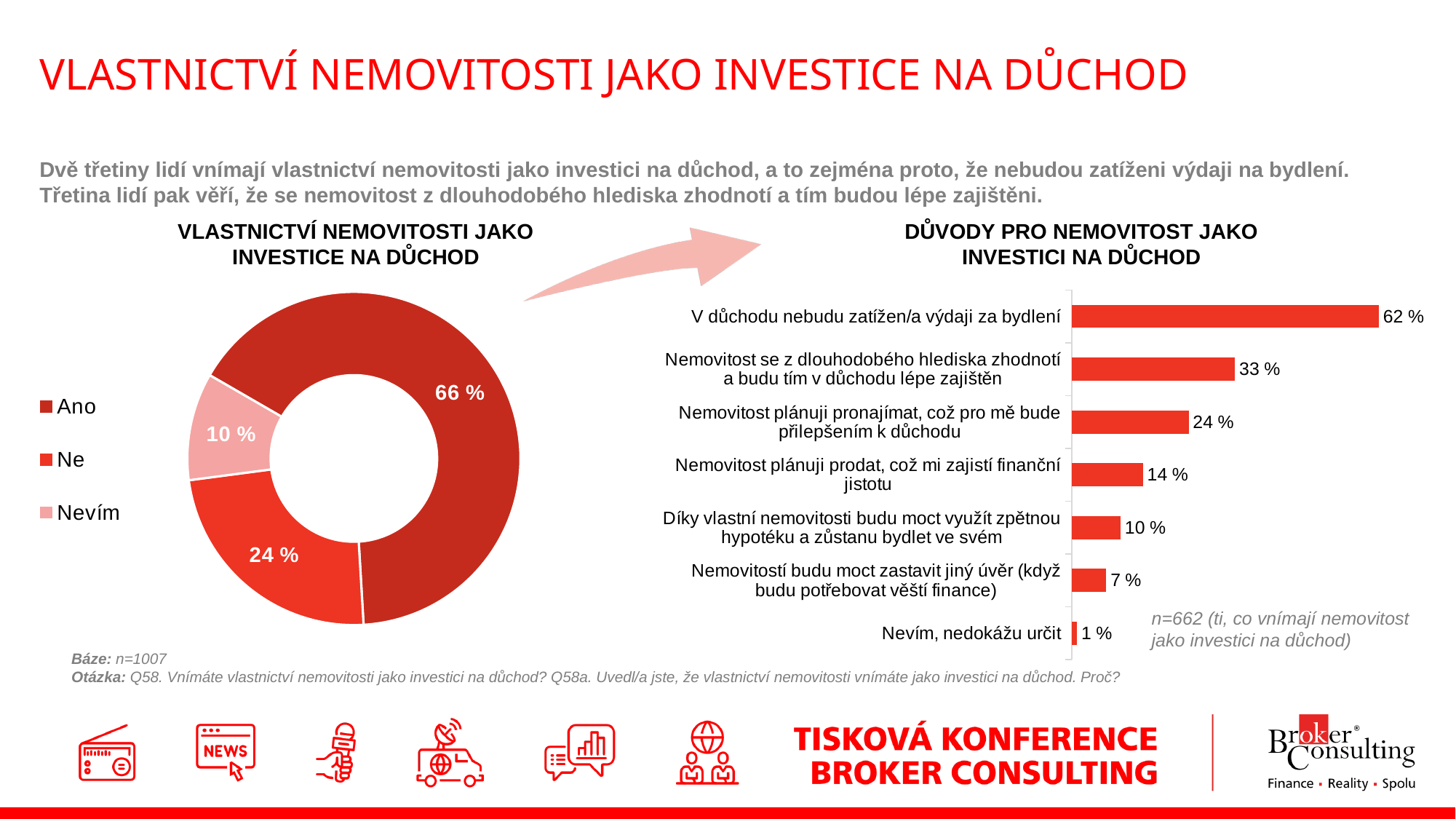
In the chart titled 'VLASTNICTVÍ NEMOVITOSTI JAKO INVESTICE NA DŮCHOD', what kind of chart is shown? Doughnut (pie) chart In the chart titled 'VLASTNICTVÍ NEMOVITOSTI JAKO INVESTICE NA DŮCHOD', what is the difference in percentage points between 'Ano' and 'Ne'? 42 percentage points In the chart titled 'DŮVODY PRO NEMOVITOST JAKO INVESTICI NA DŮCHOD', what is the value for 'V důchodu nebudu zatížen/a výdaji za bydlení'? 62 % In the chart titled 'VLASTNICTVÍ NEMOVITOSTI JAKO INVESTICE NA DŮCHOD', what share of respondents answered 'Nevím'? 10 % In the chart titled 'VLASTNICTVÍ NEMOVITOSTI JAKO INVESTICE NA DŮCHOD', what share of respondents answered 'Ano'? 66 % In the chart titled 'VLASTNICTVÍ NEMOVITOSTI JAKO INVESTICE NA DŮCHOD', how many categories does the legend list? 3 In the chart titled 'DŮVODY PRO NEMOVITOST JAKO INVESTICI NA DŮCHOD', what kind of chart is shown? Bar chart In the chart titled 'DŮVODY PRO NEMOVITOST JAKO INVESTICI NA DŮCHOD', how many categories are plotted? 7 In the chart titled 'DŮVODY PRO NEMOVITOST JAKO INVESTICI NA DŮCHOD', what is the value for 'Nemovitost plánuji prodat, což mi zajistí finanční jistotu'? 14 % In the chart titled 'DŮVODY PRO NEMOVITOST JAKO INVESTICI NA DŮCHOD', which reason has the lowest value? Nevím, nedokážu určit In the chart titled 'VLASTNICTVÍ NEMOVITOSTI JAKO INVESTICE NA DŮCHOD', which answer has the smallest slice? Nevím In the chart titled 'DŮVODY PRO NEMOVITOST JAKO INVESTICI NA DŮCHOD', what is the difference between the values for 'Nemovitost se z dlouhodobého hlediska zhodnotí a budu tím v důchodu lépe zajištěn' and 'Nemovitost plánuji pronajímat, což pro mě bude přilepšením k důchodu'? 9 percentage points